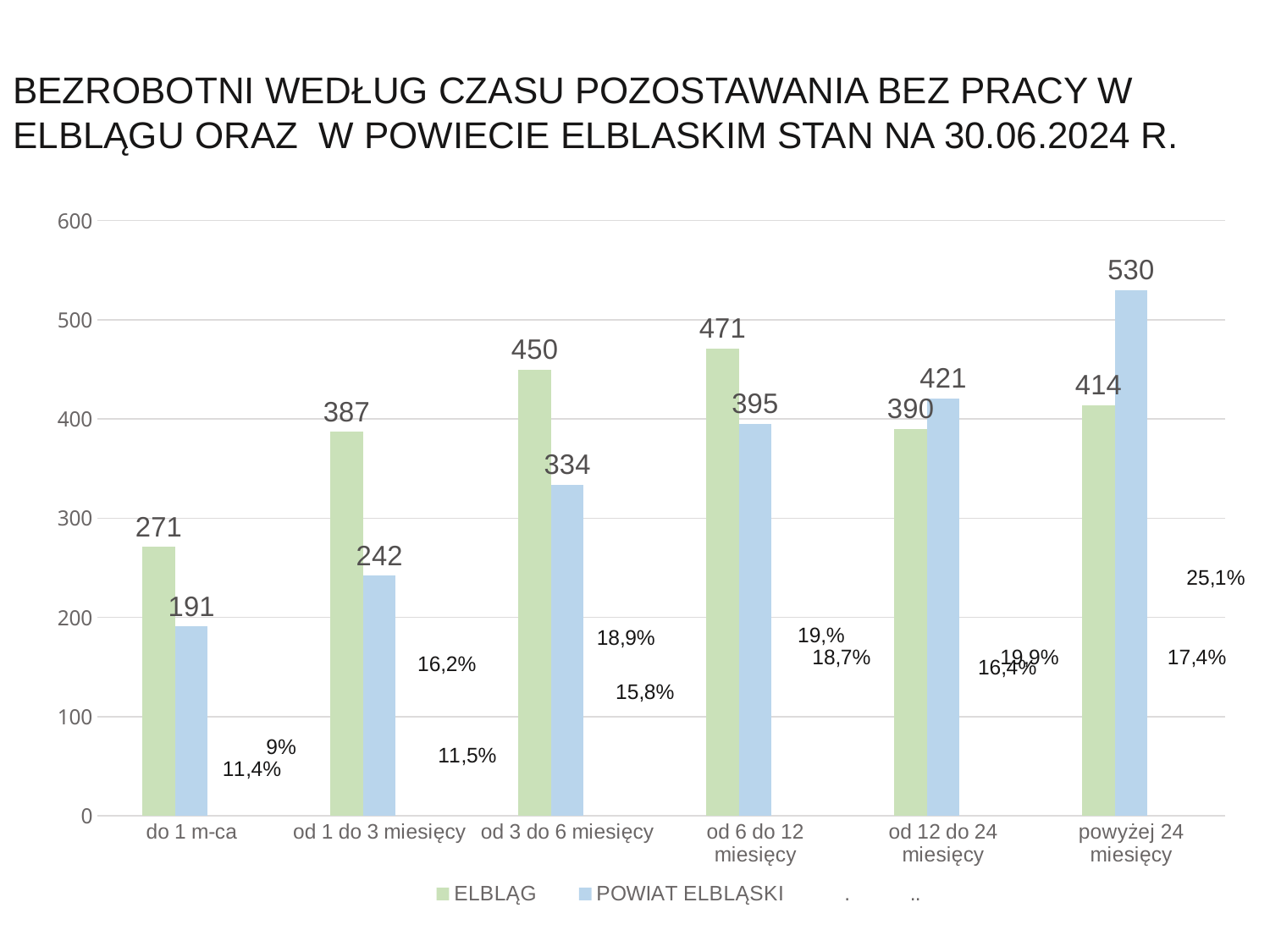
How many categories are shown on the x axis? 6 Which category has the highest value for ELBLĄG? od 6 do 12 miesięcy Is the value for POWIAT ELBLĄSKI in 'od 6 do 12 miesięcy' greater or less than 400? less What kind of chart is shown on the slide? bar chart Which category has the lowest value for POWIAT ELBLĄSKI? do 1 m-ca What is the value for POWIAT ELBLĄSKI in the category 'powyżej 24 miesięcy'? 530 What colour are the bars for the ELBLĄG series? green What is the value for POWIAT ELBLĄSKI in the category 'od 3 do 6 miesięcy'? 334 What is the difference between the ELBLĄG and POWIAT ELBLĄSKI values in the category 'od 1 do 3 miesięcy'? 145 In the category 'od 12 do 24 miesięcy', which series has the larger value, ELBLĄG or POWIAT ELBLĄSKI? POWIAT ELBLĄSKI What is the value for ELBLĄG in the category 'do 1 m-ca'? 271 Do the POWIAT ELBLĄSKI values rise or fall from 'do 1 m-ca' to 'powyżej 24 miesięcy'? rise